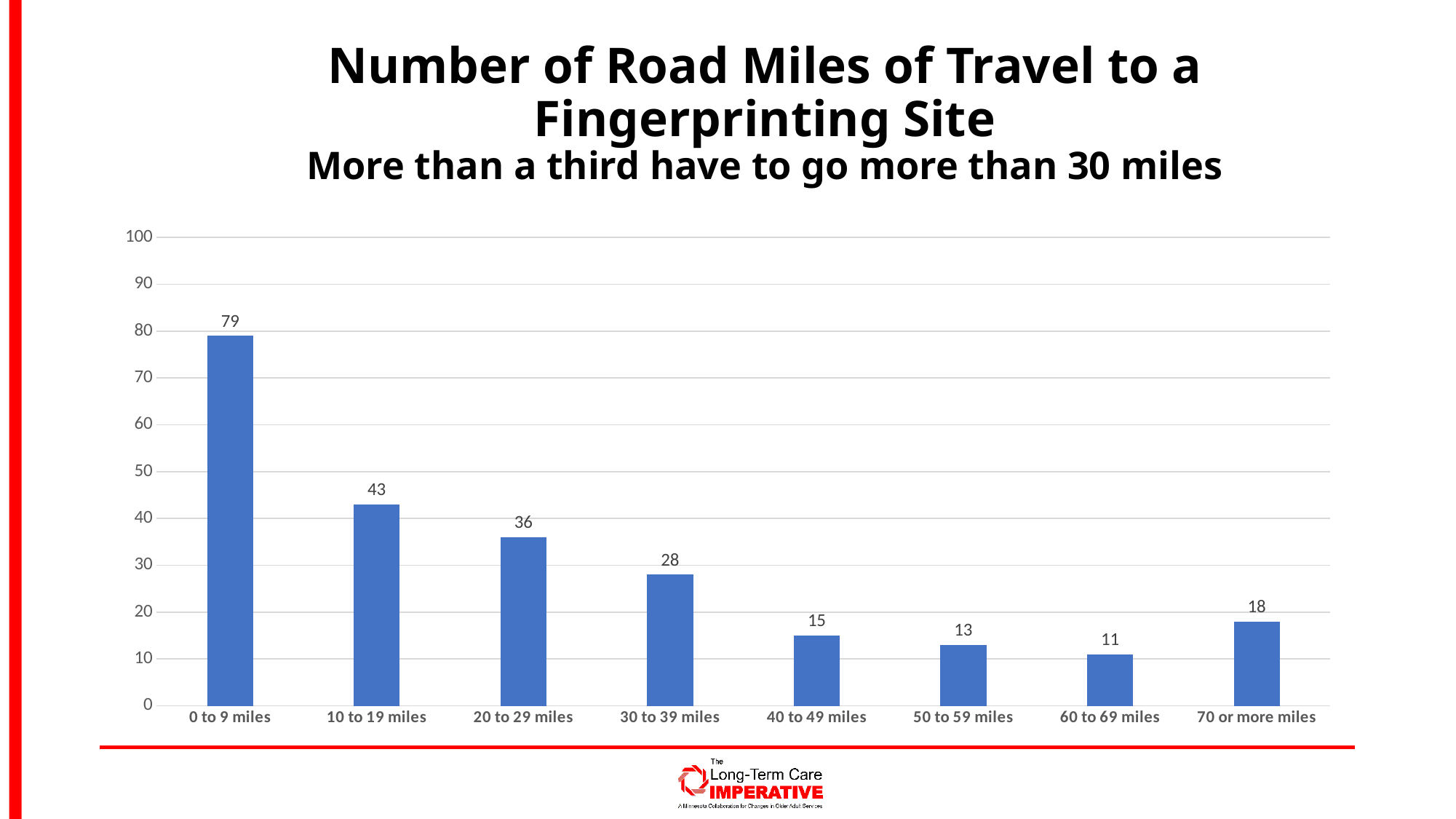
What is the difference between the values for 20 to 29 miles and 70 or more miles? 18 What is the value for the 70 or more miles category? 18 What is the difference between the values for 0 to 9 miles and 10 to 19 miles? 36 What is the title of the chart? Number of Road Miles of Travel to a Fingerprinting Site How many categories are shown on the x axis? 8 Which category has the lowest value? 60 to 69 miles Which is larger, the value for 40 to 49 miles or the value for 70 or more miles? 70 or more miles Which category has the highest value? 0 to 9 miles What is the value for the 30 to 39 miles category? 28 Is the value for 10 to 19 miles greater or less than 50? less What is the value for the 0 to 9 miles category? 79 What kind of chart is shown on the slide? bar chart